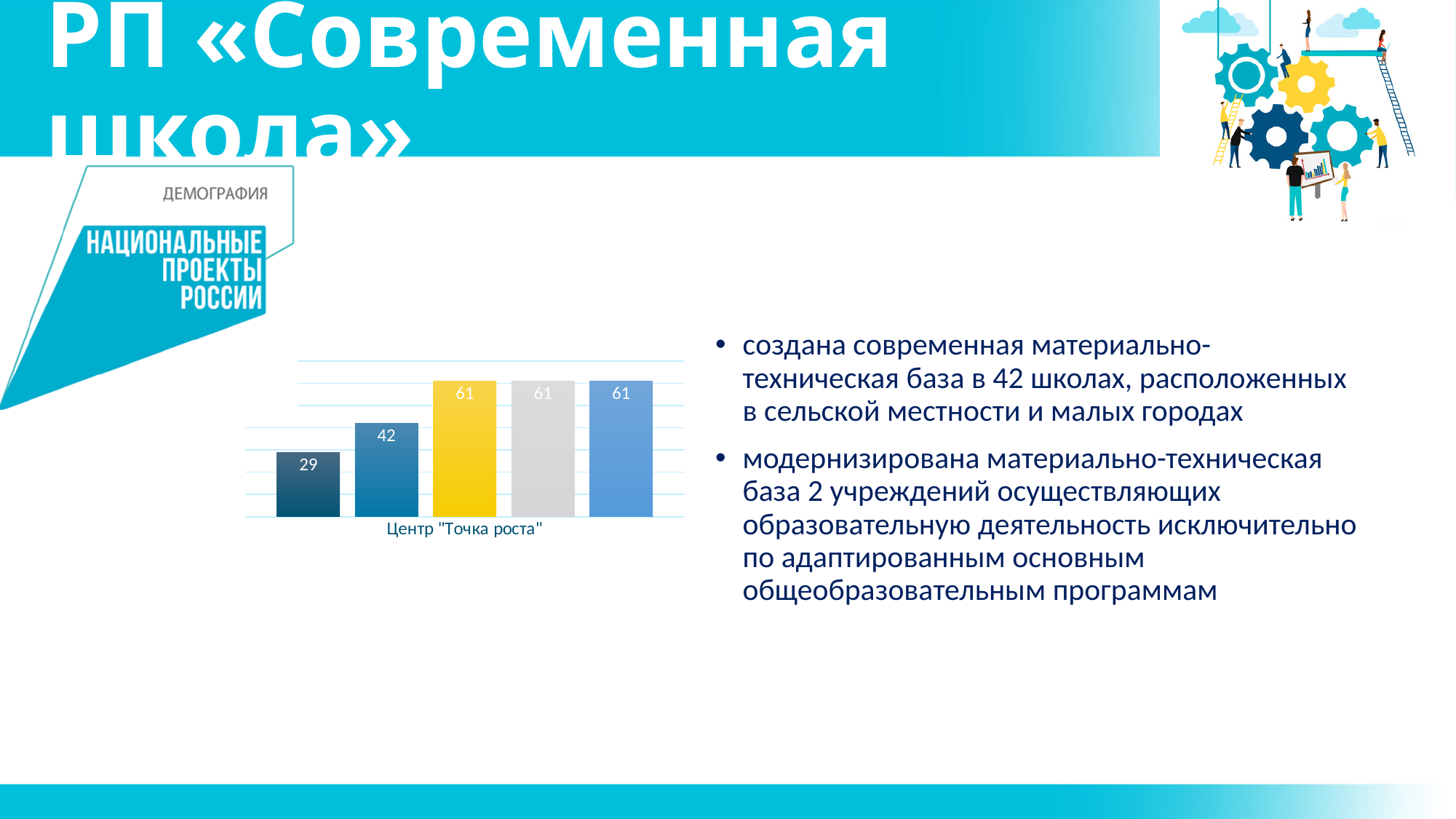
What kind of chart is shown on the slide? bar chart Which is larger in the chart: the first bar or the second bar? the second bar What is the value of the first (leftmost, dark blue) bar in the chart? 29 How many bars are plotted in the chart? 5 What is the lowest value shown in the chart? 29 What is the value of the yellow bar in the chart? 61 What is the difference between the second bar (42) and the first bar (29) in the chart? 13 What is the difference between the yellow bar and the leftmost bar in the chart? 32 What is the value of the second bar from the left in the chart? 42 What is the category label shown under the bars of the chart? Центр "Точка роста" What is the value of the grey bar in the chart? 61 What is the highest value shown in the chart? 61